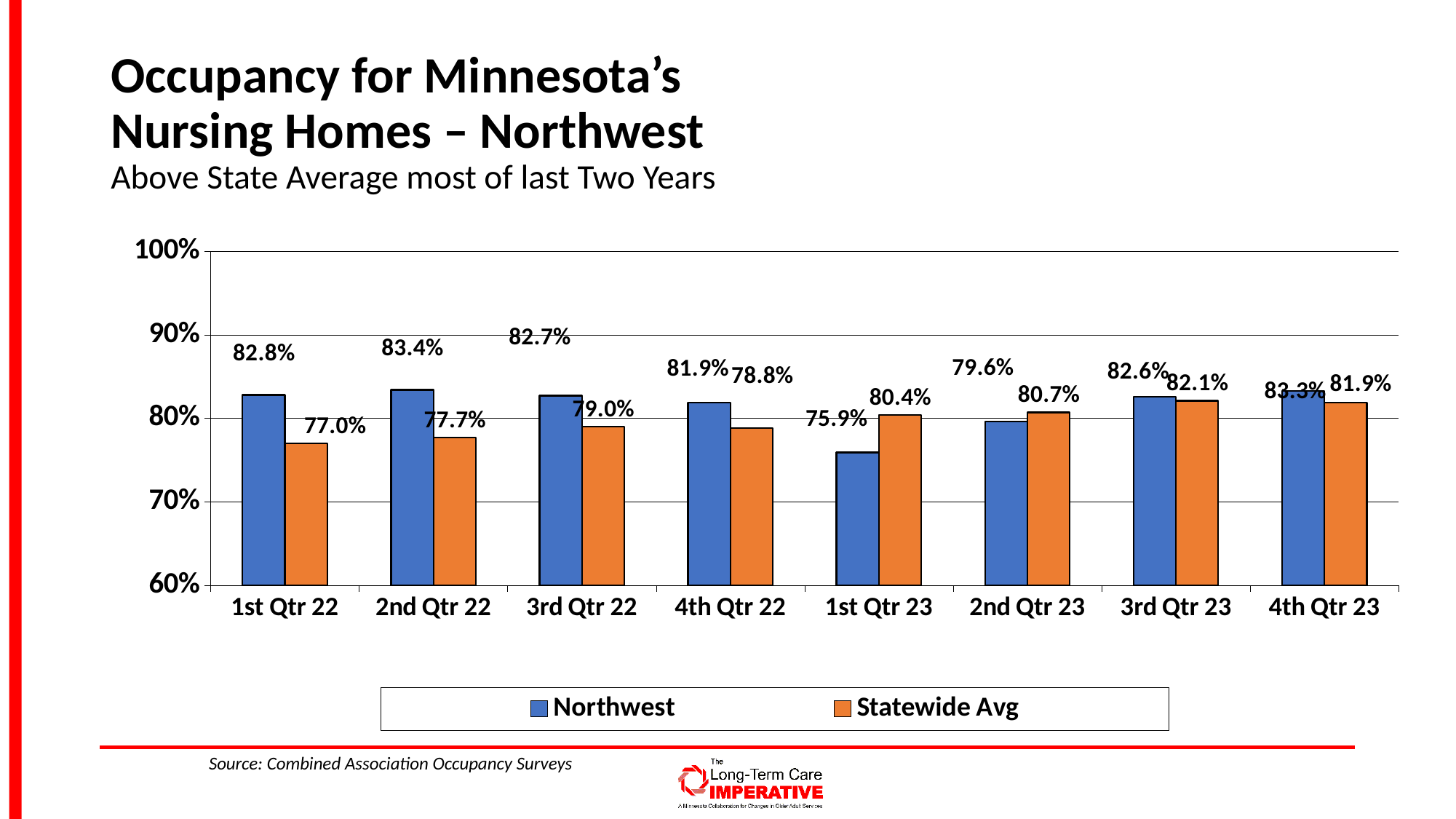
What is the Statewide Avg value for 3rd Qtr 22? 79.0% What is the Northwest value for 1st Qtr 23? 75.9% In 1st Qtr 23, which is larger: Northwest or Statewide Avg? Statewide Avg What is the difference between the Northwest and Statewide Avg values in 1st Qtr 22? 5.8 percentage points How many series does the legend list? 2 Does the Statewide Avg value rise or fall from 1st Qtr 22 to 3rd Qtr 23? Rise What kind of chart is shown on the slide? Bar chart What is the Northwest occupancy value for 1st Qtr 22? 82.8% How many quarters are shown on the x axis? 8 In which quarter is the Northwest value lowest? 1st Qtr 23 What is the difference between the Statewide Avg and Northwest values in 2nd Qtr 23? 1.1 percentage points In which quarter is the Statewide Avg value highest? 3rd Qtr 23